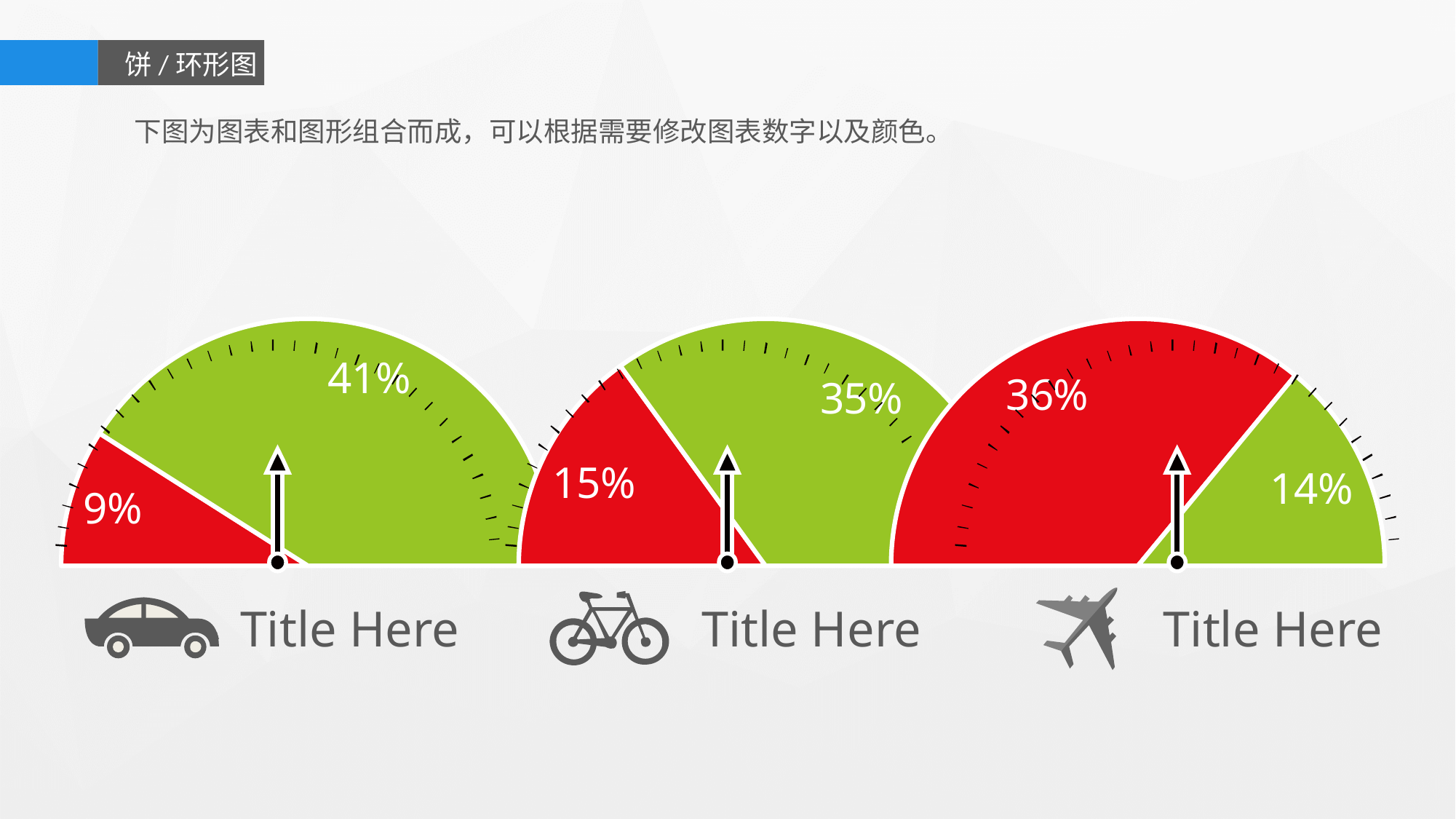
In the middle gauge chart (with the bicycle icon), what value is shown on the red segment? 15% In the right gauge chart (with the airplane icon), what value is shown on the green segment? 14% In the middle gauge chart (with the bicycle icon), which segment has the larger value, red or green? green In the right gauge chart (with the airplane icon), which segment has the larger value, red or green? red In the right gauge chart (with the airplane icon), what value is shown on the red segment? 36% In the left gauge chart (with the car icon), what value is shown on the red segment? 9% In the left gauge chart (with the car icon), what value is shown on the green segment? 41% What two colours are used for the segments in each gauge chart? red and green In the left gauge chart (with the car icon), what is the difference between the green and red segment values? 32% In the middle gauge chart (with the bicycle icon), what value is shown on the green segment? 35% In the right gauge chart (with the airplane icon), what is the difference between the red and green segment values? 22% How many gauge charts are shown on the slide? 3